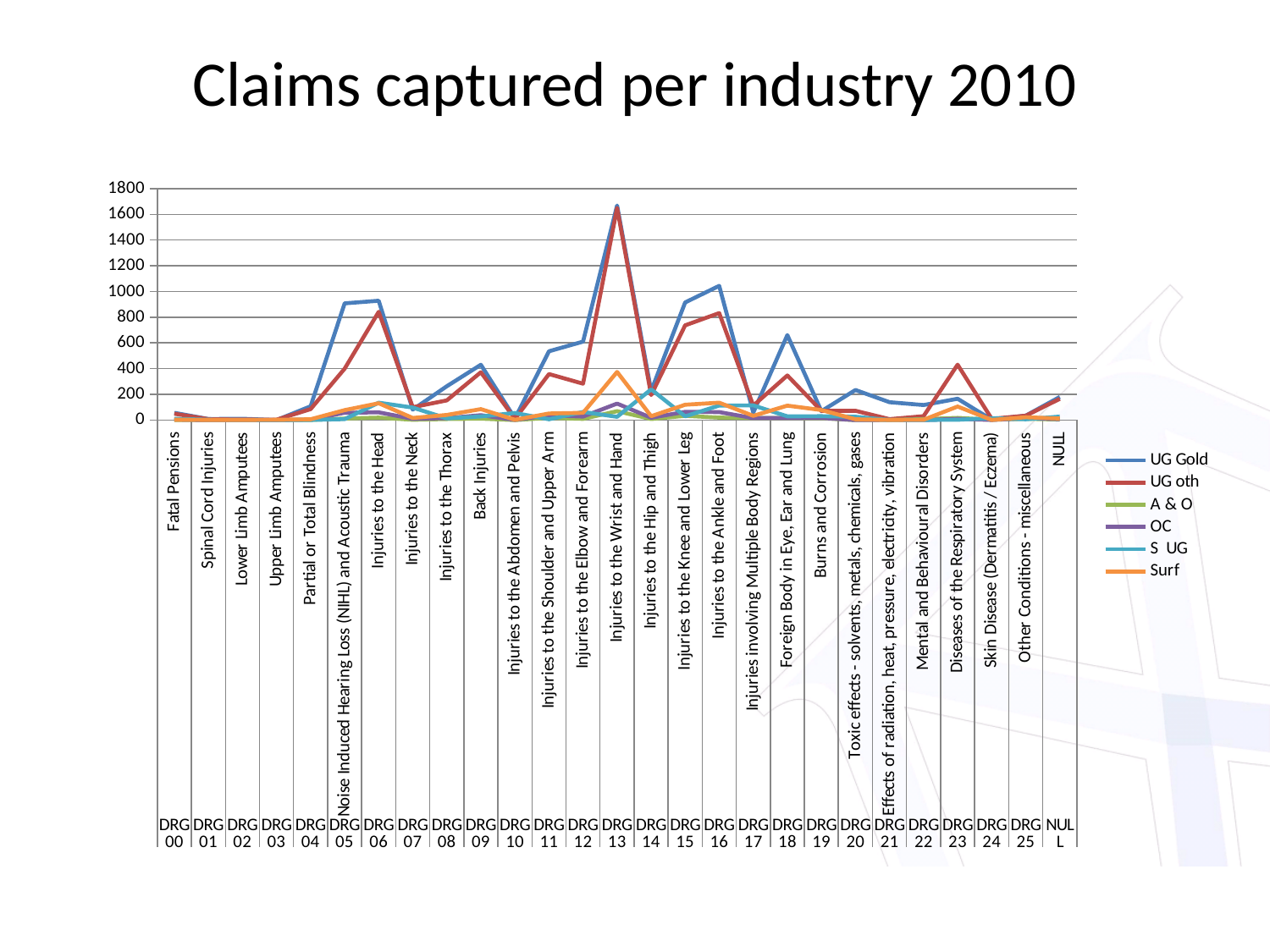
For which category does the UG Gold series reach its highest value? Injuries to the Wrist and Hand How many categories are plotted along the x axis? 27 Which series has the larger value for Diseases of the Respiratory System, UG Gold or UG oth? UG oth For which category does the UG oth series reach its highest value? Injuries to the Wrist and Hand What kind of chart is shown on the slide? line chart Is the UG oth value for Injuries to the Ankle and Foot greater or less than 600? greater For which category does the Surf series reach its highest value? Injuries to the Wrist and Hand Is the UG Gold value for Injuries to the Wrist and Hand greater or less than 1400? greater Which series has the larger value for Foreign Body in Eye, Ear and Lung, UG Gold or UG oth? UG Gold Is the UG Gold value for Noise Induced Hearing Loss (NIHL) and Acoustic Trauma greater or less than 600? greater What is the title of the chart? Claims captured per industry 2010 How many series does the legend list? 6